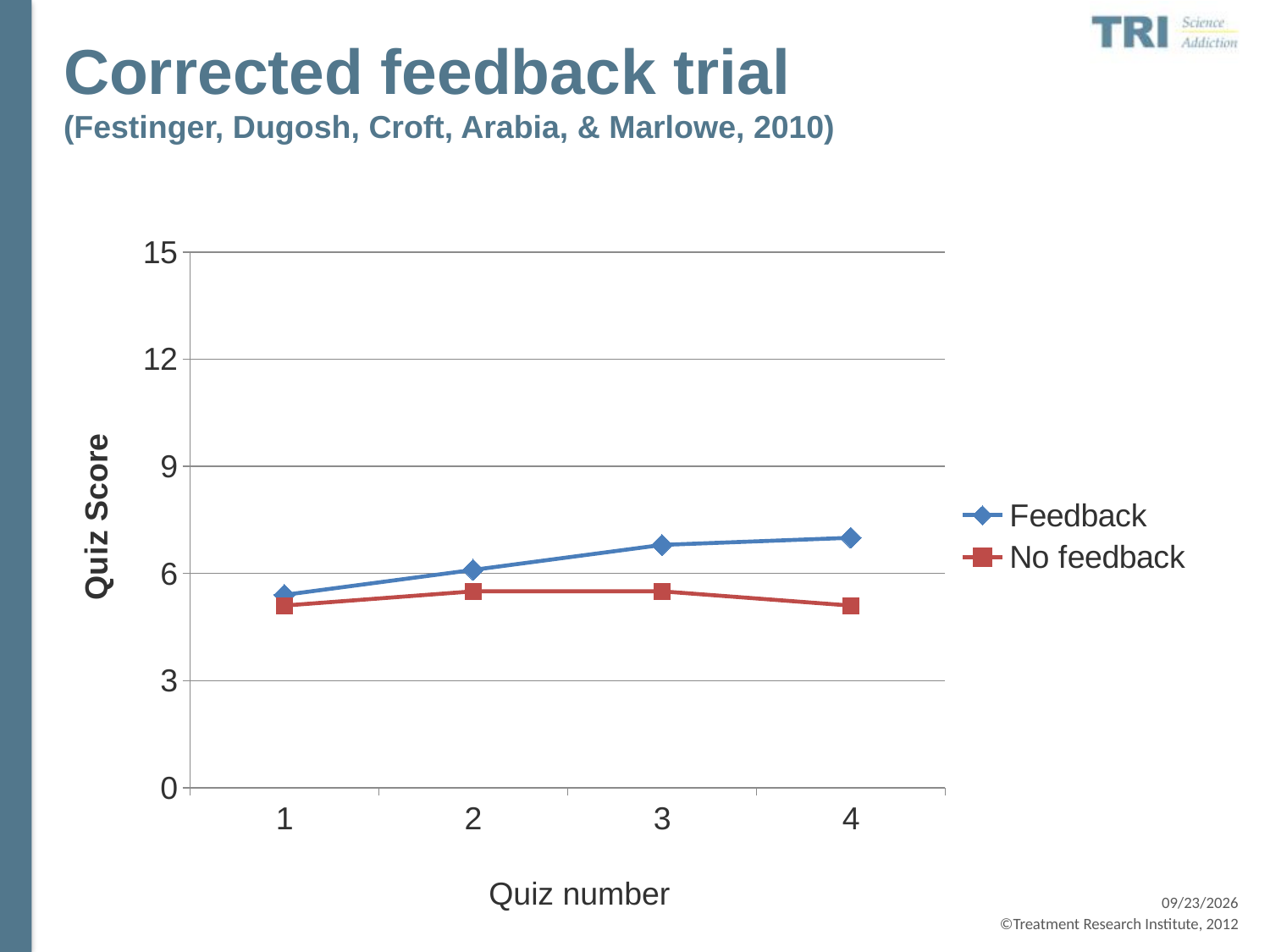
At which quiz number is the Feedback series lowest? 1 Is the No feedback value at quiz 4 greater or less than 6? less Is the No feedback value at quiz 1 greater or less than 6? less Is the Feedback value at quiz 3 greater or less than 6? greater At quiz 4, which series has the higher quiz score, Feedback or No feedback? Feedback What kind of chart is shown on the slide? line chart What is the title of the vertical axis? Quiz Score Does the Feedback series rise or fall from quiz 1 to quiz 4? rise How many series does the legend list? 2 How many quiz numbers are plotted along the x axis? 4